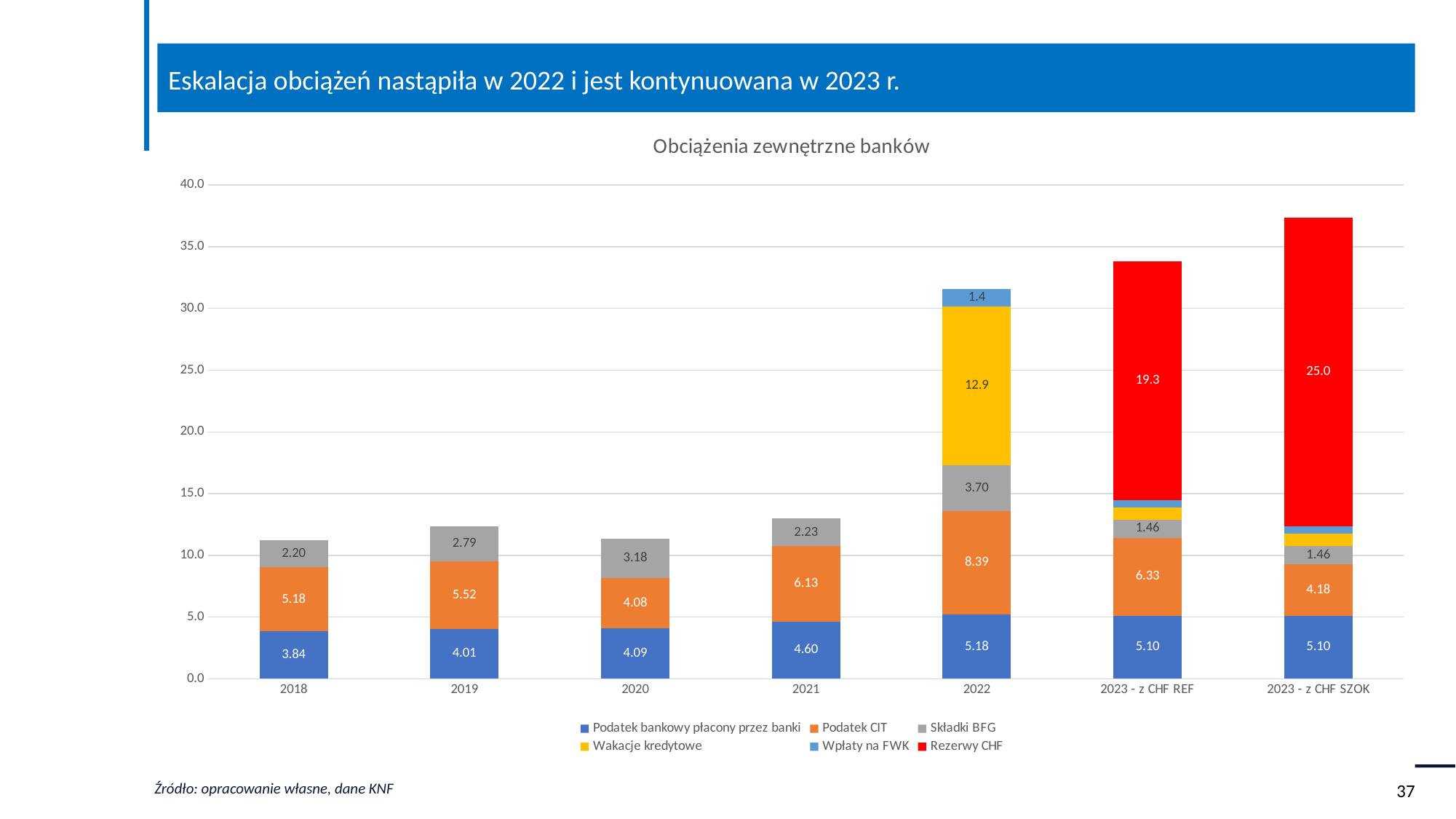
Which is larger, Podatek bankowy płacony przez banki for 2021 or for 2020? 2021 What is the difference between Rezerwy CHF for 2023 - z CHF SZOK and 2023 - z CHF REF? 5.7 In which category is Podatek bankowy płacony przez banki the lowest? 2018 Is the total of the bar for 2023 - z CHF SZOK greater or less than 35.0? greater In which category is Podatek CIT the highest? 2022 What is the value of Wakacje kredytowe for 2022? 12.9 What is the total of the stacked bar for 2018? 11.22 How many categories are shown on the x axis? 7 How many series does the legend list? 6 What kind of chart is shown on the slide? Stacked bar chart What is the value of Podatek CIT for 2022? 8.39 What is the value of Rezerwy CHF for 2023 - z CHF SZOK? 25.0